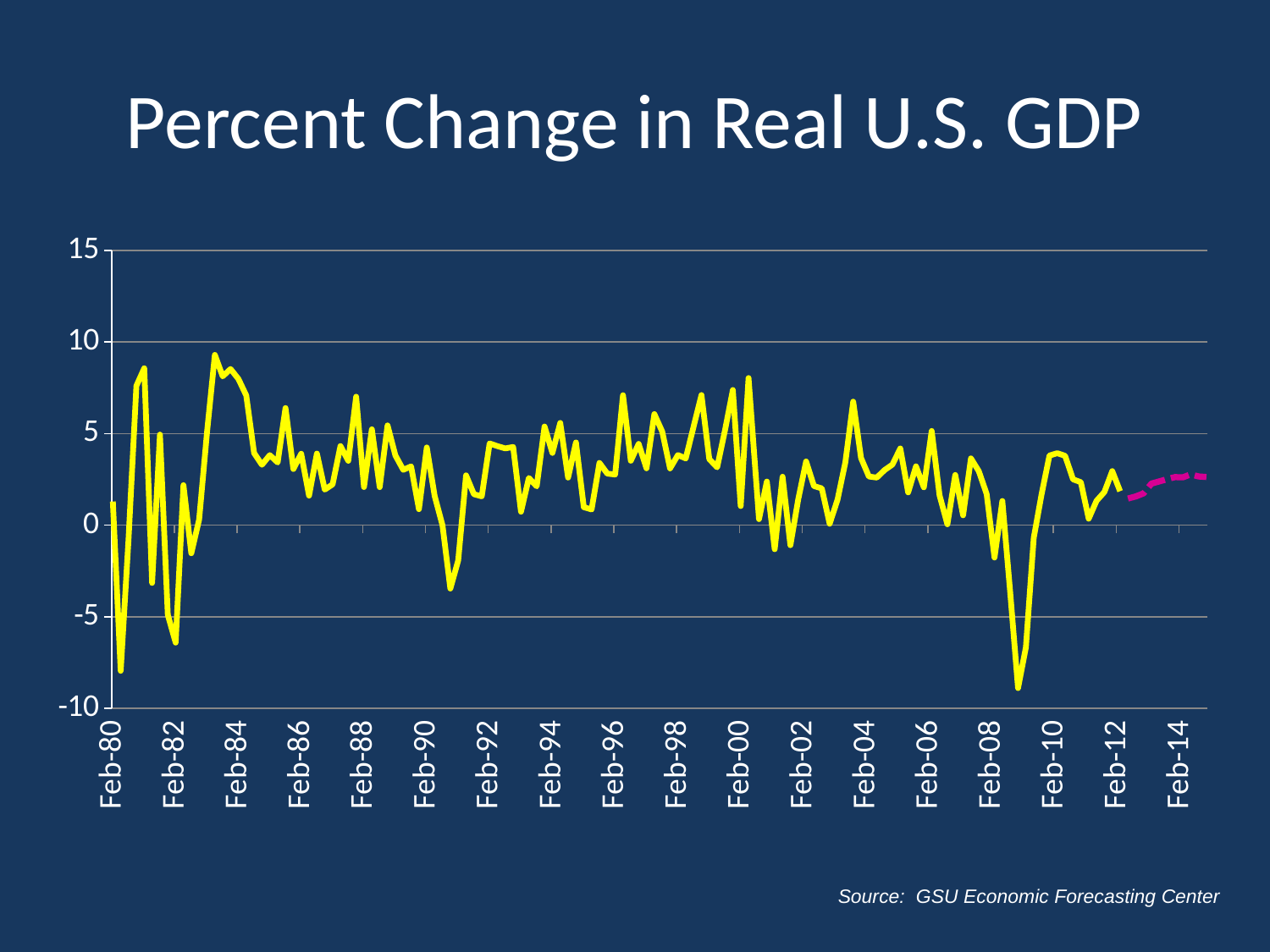
What kind of chart is shown on the slide? line chart What source is cited for the chart? GSU Economic Forecasting Center Is the peak value of the line near Feb-84 greater or less than 5? greater Is the lowest value of the line between Feb-08 and Feb-10 greater or less than -5? less How many labels are shown on the x axis? 18 Is the lowest value of the line shortly after Feb-80 greater or less than -5? less Around which x-axis label does the line reach its highest value? Feb-84 What is the title of the chart? Percent Change in Real U.S. GDP Does the dashed segment at the right end of the line rise or fall from Feb-12 toward Feb-14? rise Between which two x-axis labels does the line reach its lowest value? Feb-08 and Feb-10